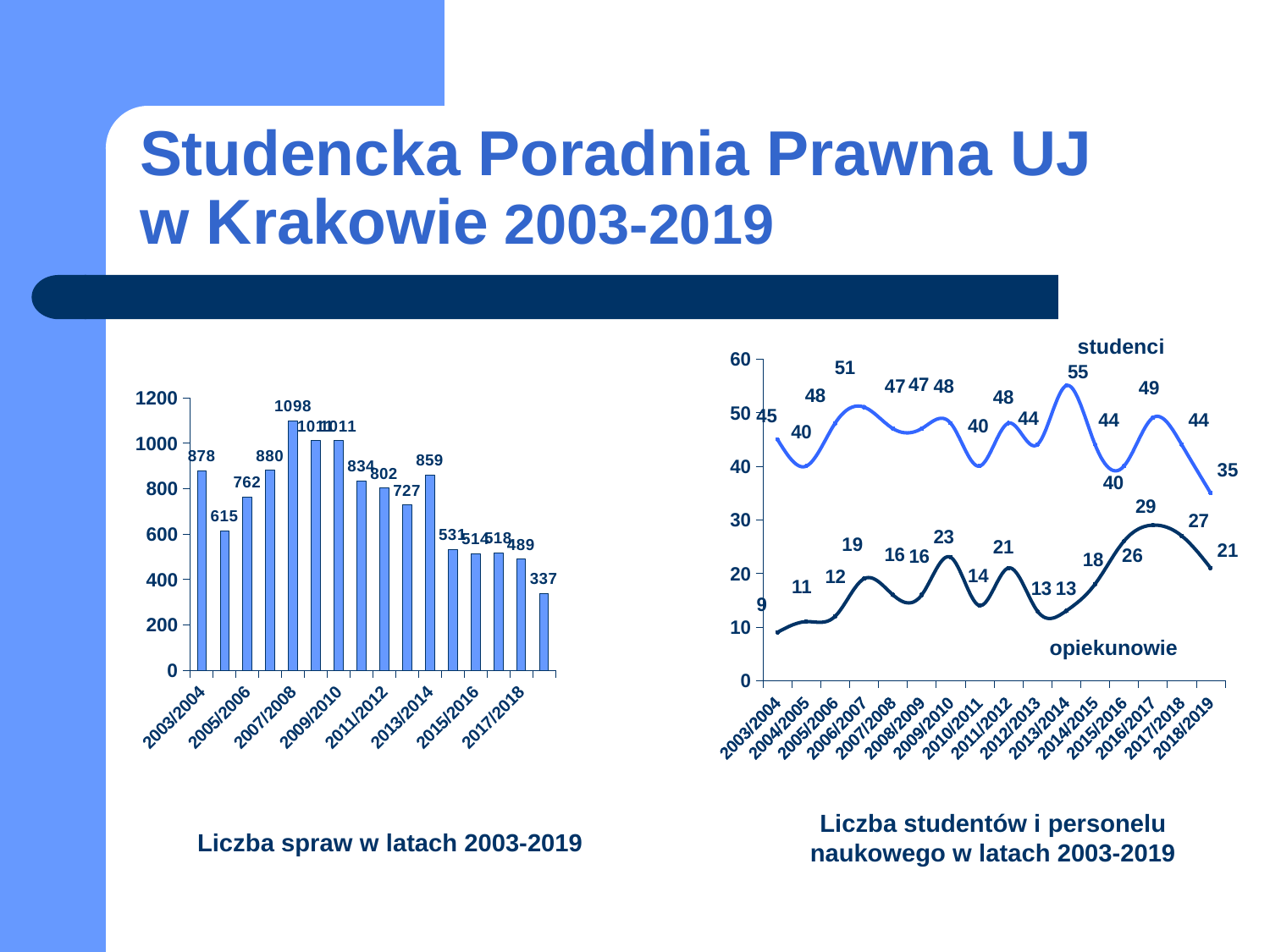
In the left chart 'Liczba spraw w latach 2003-2019', what is the value for 2003/2004? 878 In the left chart 'Liczba spraw w latach 2003-2019', what is the lowest value shown? 337 In the left chart 'Liczba spraw w latach 2003-2019', what is the value for 2017/2018? 489 What type of chart is the left chart, 'Liczba spraw w latach 2003-2019'? bar chart In the left chart 'Liczba spraw w latach 2003-2019', what is the difference between the value for 2003/2004 and the value for 2018/2019? 541 In the right chart 'Liczba studentów i personelu naukowego w latach 2003-2019', what is the difference between 'studenci' and 'opiekunowie' in 2018/2019? 14 In the right chart 'Liczba studentów i personelu naukowego w latach 2003-2019', is the 'studenci' value higher in 2003/2004 or in 2018/2019? 2003/2004 In the left chart 'Liczba spraw w latach 2003-2019', which year has the highest number of cases? 2007/2008 In the right chart 'Liczba studentów i personelu naukowego w latach 2003-2019', what is the value of 'opiekunowie' for 2016/2017? 29 In the right chart 'Liczba studentów i personelu naukowego w latach 2003-2019', what is the highest value of the 'studenci' series? 55 How many academic years are shown on the x axis of the right chart 'Liczba studentów i personelu naukowego w latach 2003-2019'? 16 How many series are plotted in the right chart 'Liczba studentów i personelu naukowego w latach 2003-2019'? 2